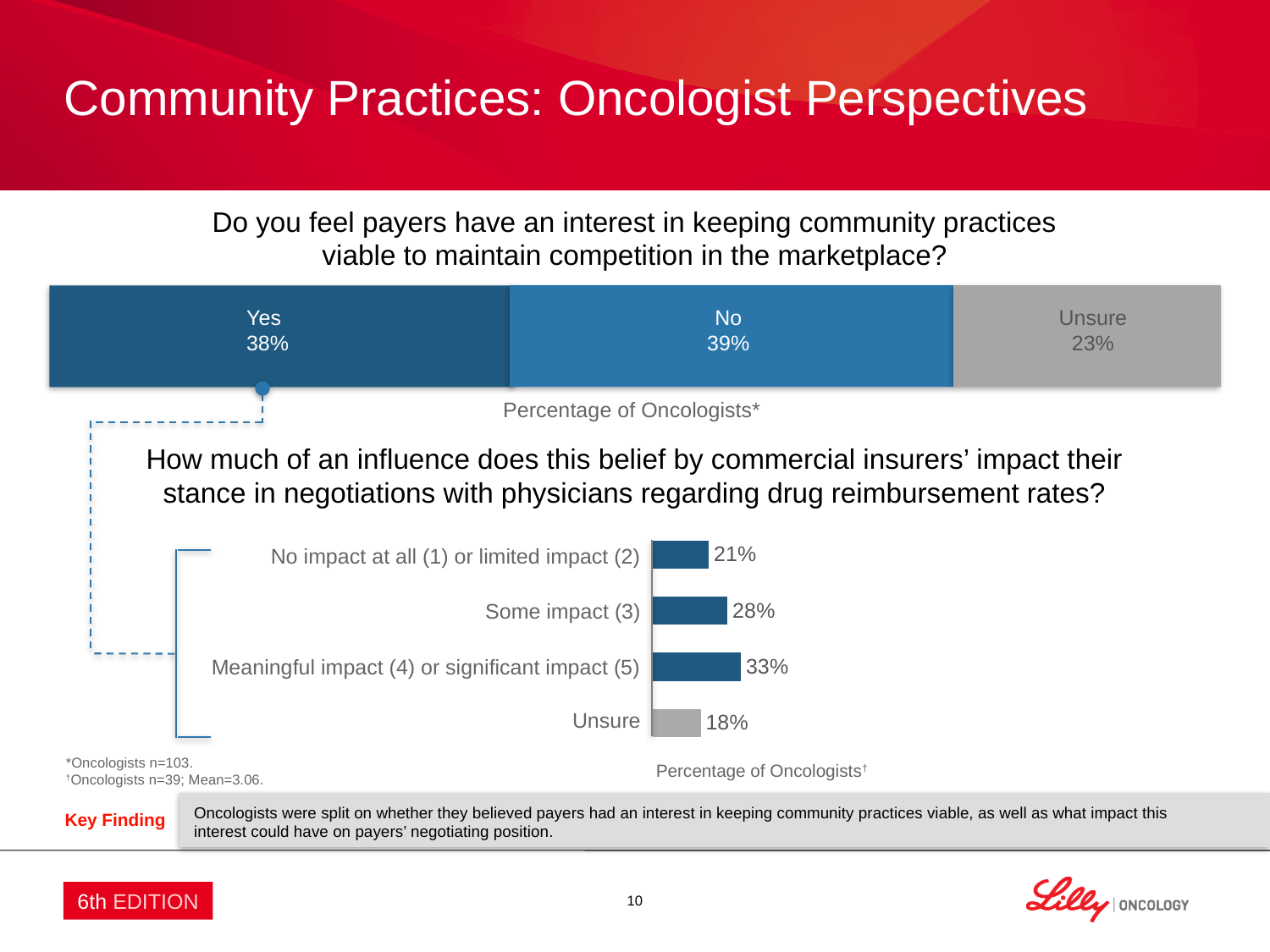
In the bottom chart about the influence on negotiations regarding drug reimbursement rates, which category has the highest percentage? Meaningful impact (4) or significant impact (5) In the bottom chart about the influence on negotiations regarding drug reimbursement rates, what is the difference between 'No impact at all (1) or limited impact (2)' and 'Unsure'? 3% In the bottom chart about the influence on negotiations regarding drug reimbursement rates, what percentage of oncologists chose 'Some impact (3)'? 28% In the top chart about whether payers have an interest in keeping community practices viable, what percentage of oncologists were Unsure? 23% In the top chart about whether payers have an interest in keeping community practices viable, what is the difference between the No and Unsure percentages? 16% In the top chart about whether payers have an interest in keeping community practices viable, what percentage of oncologists answered Yes? 38% In the top chart about whether payers have an interest in keeping community practices viable, how many response categories are shown? 3 In the bottom chart about the influence on negotiations regarding drug reimbursement rates, which category has the lowest percentage? Unsure In the top chart about whether payers have an interest in keeping community practices viable, what percentage of oncologists answered No? 39% In the top chart about whether payers have an interest in keeping community practices viable, which response had the lowest percentage? Unsure What type of chart is the bottom chart about the influence on negotiations regarding drug reimbursement rates? Bar chart In the bottom chart about the influence on negotiations regarding drug reimbursement rates, what percentage of oncologists chose 'Meaningful impact (4) or significant impact (5)'? 33%